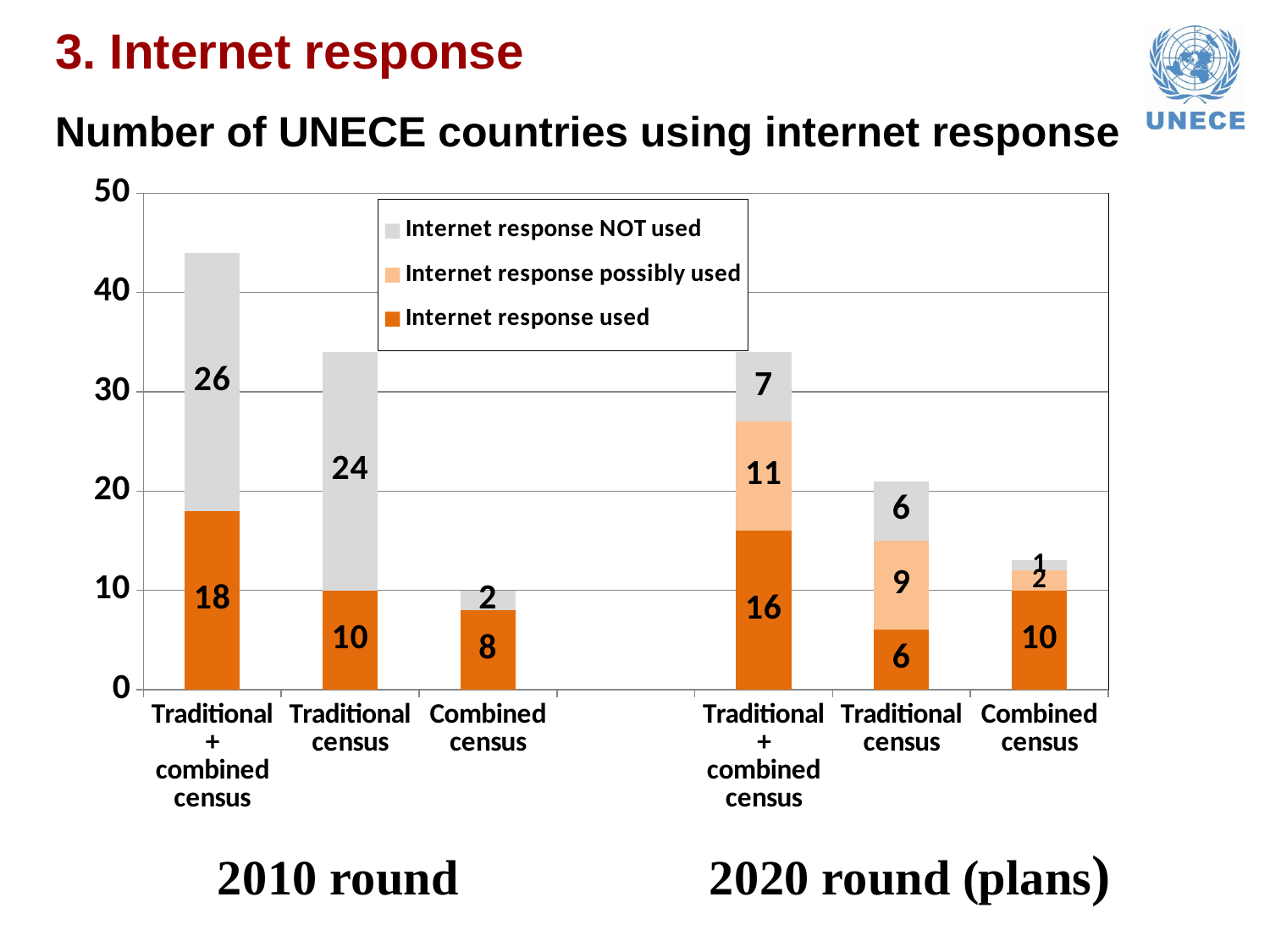
In the 2010 round, how many countries with a traditional + combined census used internet response? 18 How many series does the legend list? 3 Which is larger: the 'Internet response used' value for traditional census in the 2010 round or in the 2020 round (plans)? 2010 round Which colour represents 'Internet response NOT used' in the legend? grey In the 2020 round (plans), how many countries with a traditional census possibly use internet response? 9 What kind of chart is shown on the slide? stacked bar chart Which bar has the highest total across the whole chart? Traditional + combined census (2010 round) In the 2010 round, how many countries with a combined census did NOT use internet response? 2 Which bar has the lowest total across the whole chart? Combined census (2010 round) What is the total height of the 2010 round traditional + combined census bar? 44 What is the difference between the number of traditional census countries that did NOT use internet response in the 2010 round and the number that do NOT plan to in the 2020 round? 18 What is the total height of the 2020 round (plans) traditional census bar? 21